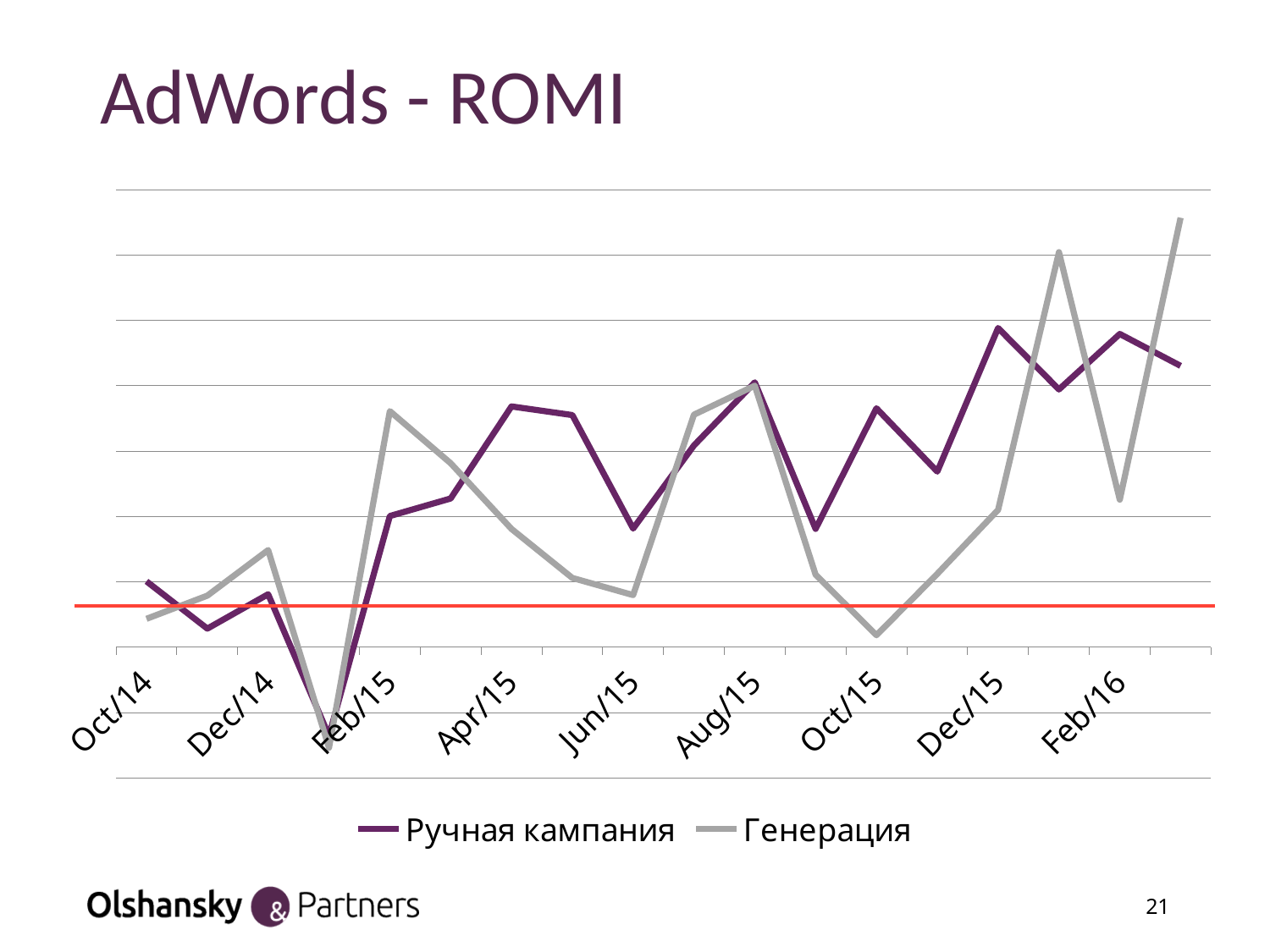
At Oct/15, which series has the higher value, Ручная кампания or Генерация? Ручная кампания Which series reaches the highest point anywhere on the chart? Генерация At Feb/15, which series has the higher value, Ручная кампания or Генерация? Генерация What kind of chart is shown on the slide? line chart At Apr/15, which series has the higher value, Ручная кампания or Генерация? Ручная кампания How many series does the legend list? 2 Overall, does the Ручная кампания line rise or fall from Oct/14 to the end of the chart? rise How many month labels are shown on the x axis? 9 What is the title of the chart? AdWords - ROMI Which series is drawn in purple? Ручная кампания